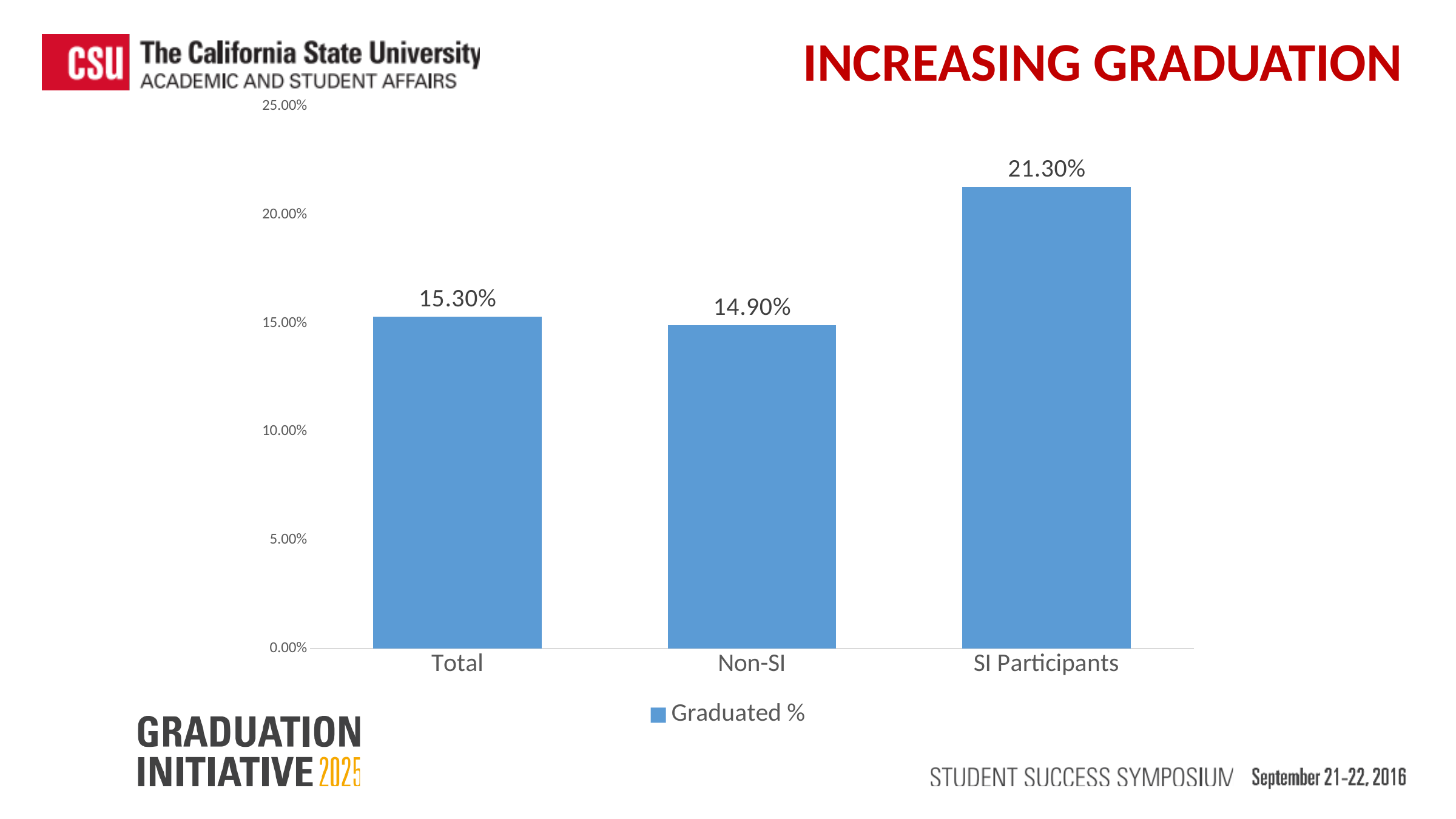
What is the Graduated % value for Non-SI? 14.90% What is the Graduated % value for SI Participants? 21.30% Which category has the lowest Graduated %? Non-SI How many series does the legend list? 1 How many categories are shown on the x axis? 3 What is the difference in Graduated % between SI Participants and Non-SI? 6.40% What is the difference in Graduated % between Total and Non-SI? 0.40% Is the Graduated % for SI Participants greater or less than 20.00%? greater Which is larger, the Graduated % for SI Participants or for Total? SI Participants What is the Graduated % value for Total? 15.30% Which category has the highest Graduated %? SI Participants What kind of chart is shown on the slide? bar chart